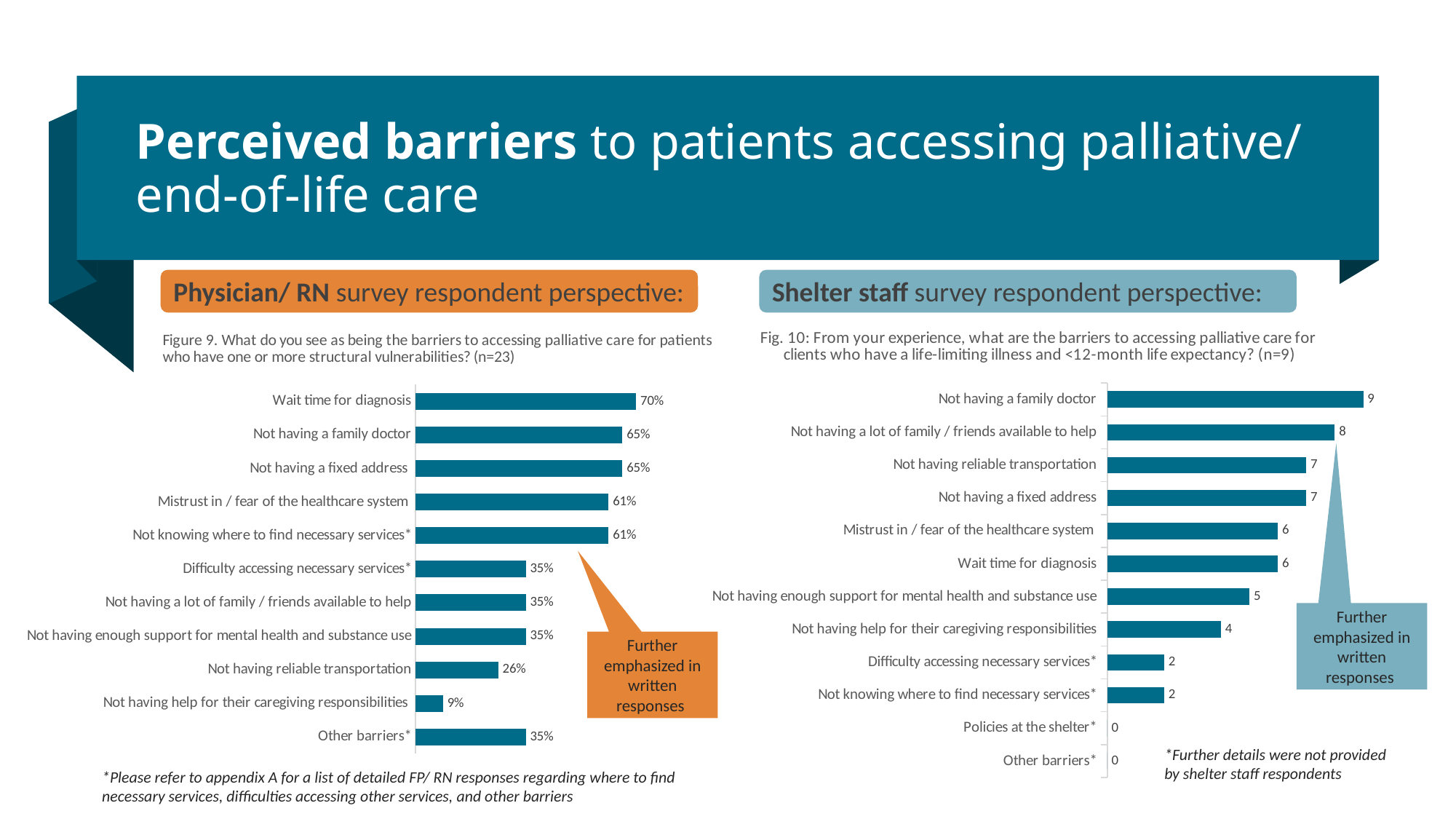
In the Physician/RN chart (Figure 9), what is the difference between 'Wait time for diagnosis' and 'Not having reliable transportation'? 44% In the Physician/RN chart (Figure 9), how many barrier categories are plotted? 11 In the Physician/RN chart (Figure 9), what percentage is shown for 'Other barriers*'? 35% In the Shelter staff chart (Fig. 10), what is the difference between 'Not having a family doctor' and 'Not having help for their caregiving responsibilities'? 5 In the Shelter staff chart (Fig. 10), which barrier has the highest value? Not having a family doctor In the Shelter staff chart (Fig. 10), how many barrier categories are plotted? 12 What type of chart is used in the Shelter staff chart (Fig. 10)? Bar chart In the Shelter staff chart (Fig. 10), which is larger: 'Not having reliable transportation' or 'Wait time for diagnosis'? Not having reliable transportation In the Physician/RN chart (Figure 9), what percentage is shown for 'Wait time for diagnosis'? 70% In the Physician/RN chart (Figure 9), which barrier has the lowest percentage? Not having help for their caregiving responsibilities In the Shelter staff chart (Fig. 10), what value is shown for 'Not having enough support for mental health and substance use'? 5 In the Shelter staff chart (Fig. 10), what is the sample size (n) stated in the figure title? n=9